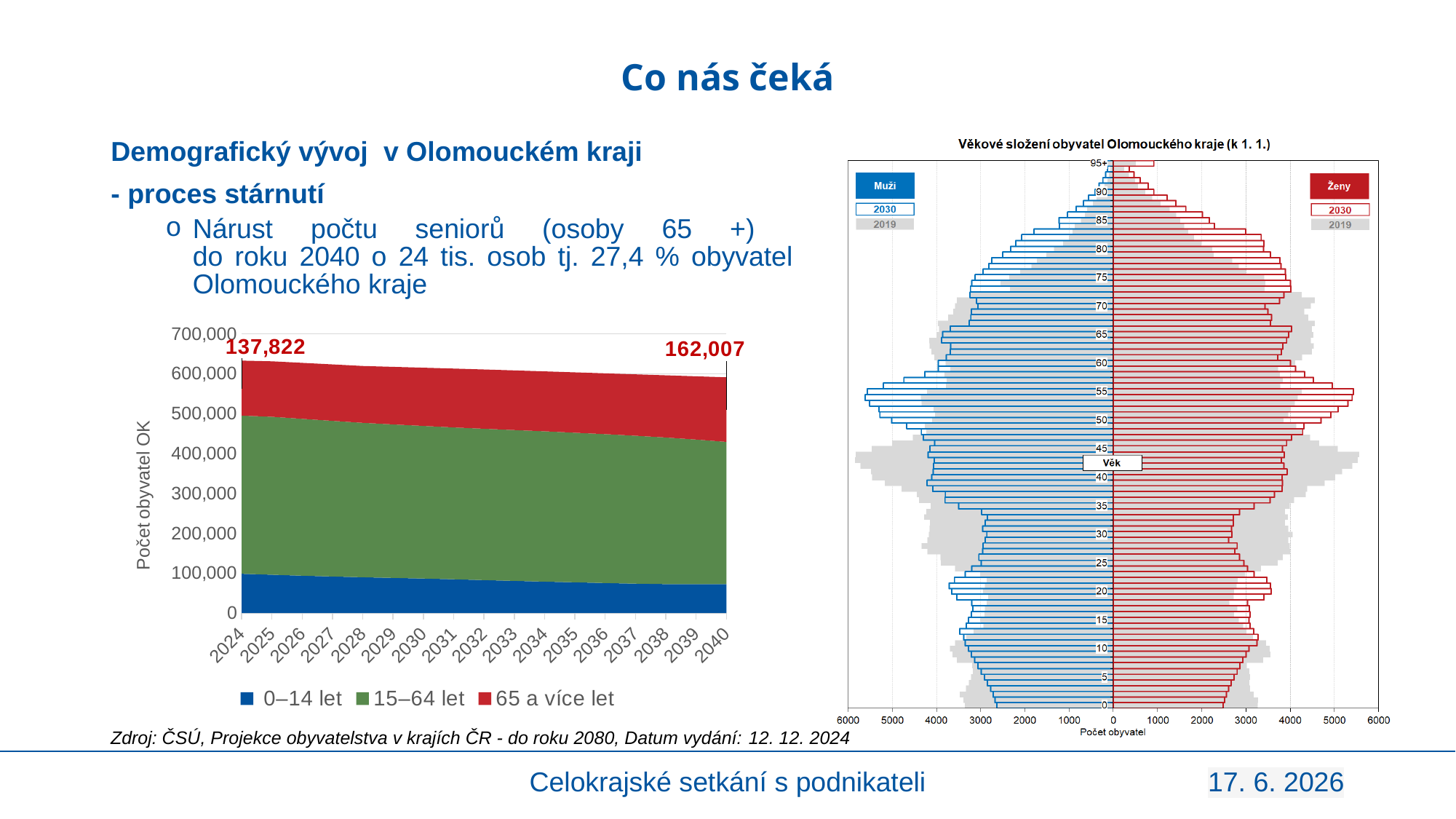
How many series does the legend of the left area chart list? 3 In the left area chart, is the total stacked value in 2024 greater or less than 600,000? greater In the left area chart, does the 0–14 let series rise or fall from 2024 to 2040? Falls In the left area chart, by how much does the labelled 65 a více let value in 2040 exceed the labelled value in 2024? 24,185 In the left area chart, what is the labelled value for the 65 a více let series in 2024? 137,822 In the left area chart, which year has the larger labelled 65 a více let value, 2024 or 2040? 2040 What kind of chart is the right chart titled 'Věkové složení obyvatel Olomouckého kraje (k 1. 1.)'? Bar chart (population pyramid) How many years are shown on the x axis of the left area chart? 17 In the left area chart, what is the labelled value for the 65 a více let series in 2040? 162,007 What kind of chart is the left chart showing Počet obyvatel OK? Stacked area chart Which two years does the legend of the right population pyramid chart compare? 2030 and 2019 In the left area chart, does the 65 a více let series rise or fall from 2024 to 2040? Rises